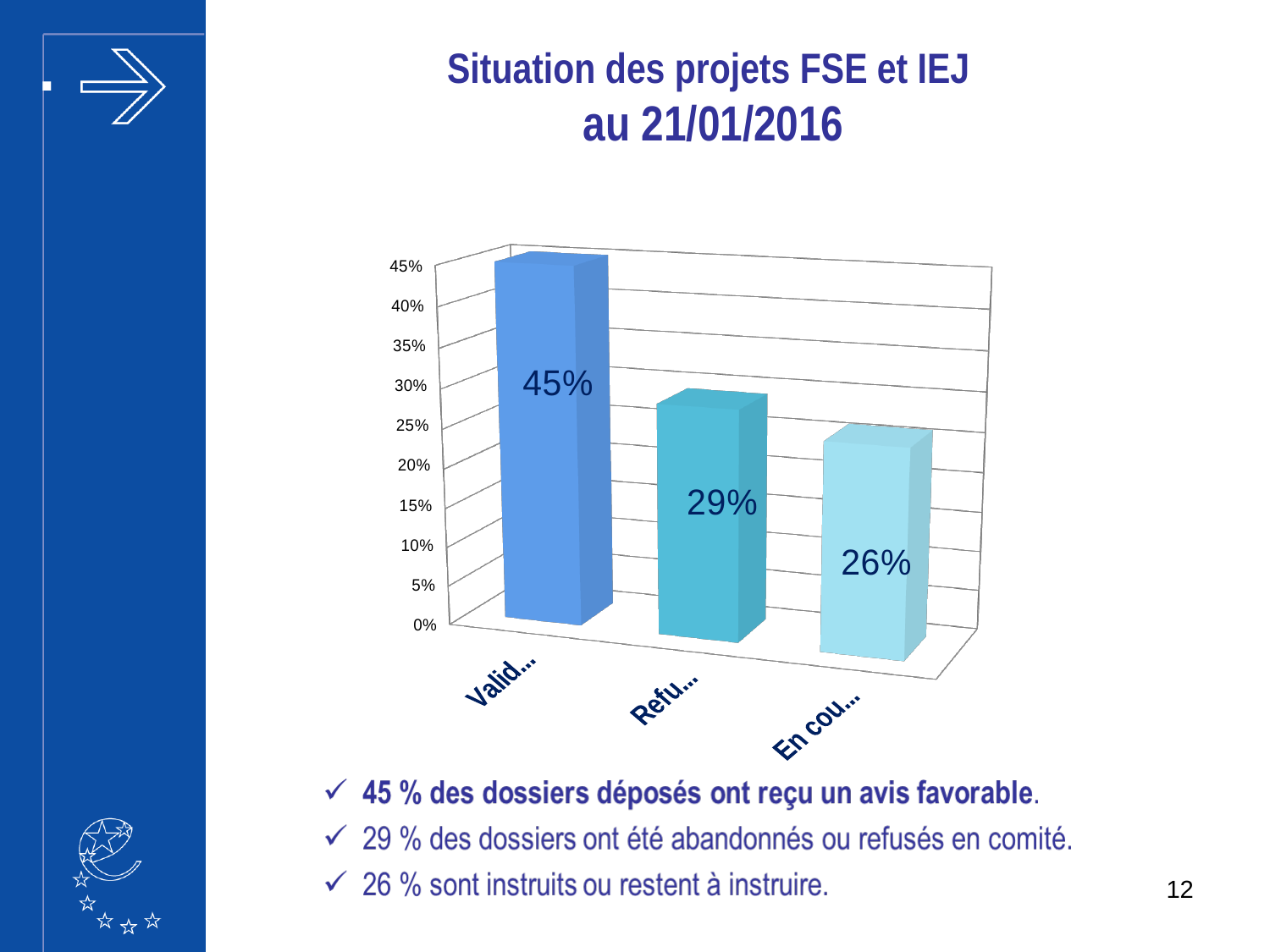
How many bars are plotted in the chart? 3 What is the difference between the "Refu..." and "En cou..." values? 3% What value is shown for the "Refu..." bar? 29% What kind of chart is shown on the slide? Bar chart Which is larger, the value for "Valid..." or the value for "En cou..."? Valid... Do the bar values rise or fall from left to right along the x axis? Fall What is the difference between the "Valid..." and "Refu..." values? 16% What is the maximum value shown on the vertical axis? 45% Which category has the lowest value? En cou... Which category has the highest value? Valid... What value is shown for the "En cou..." bar? 26% What value is shown for the "Valid..." bar? 45%